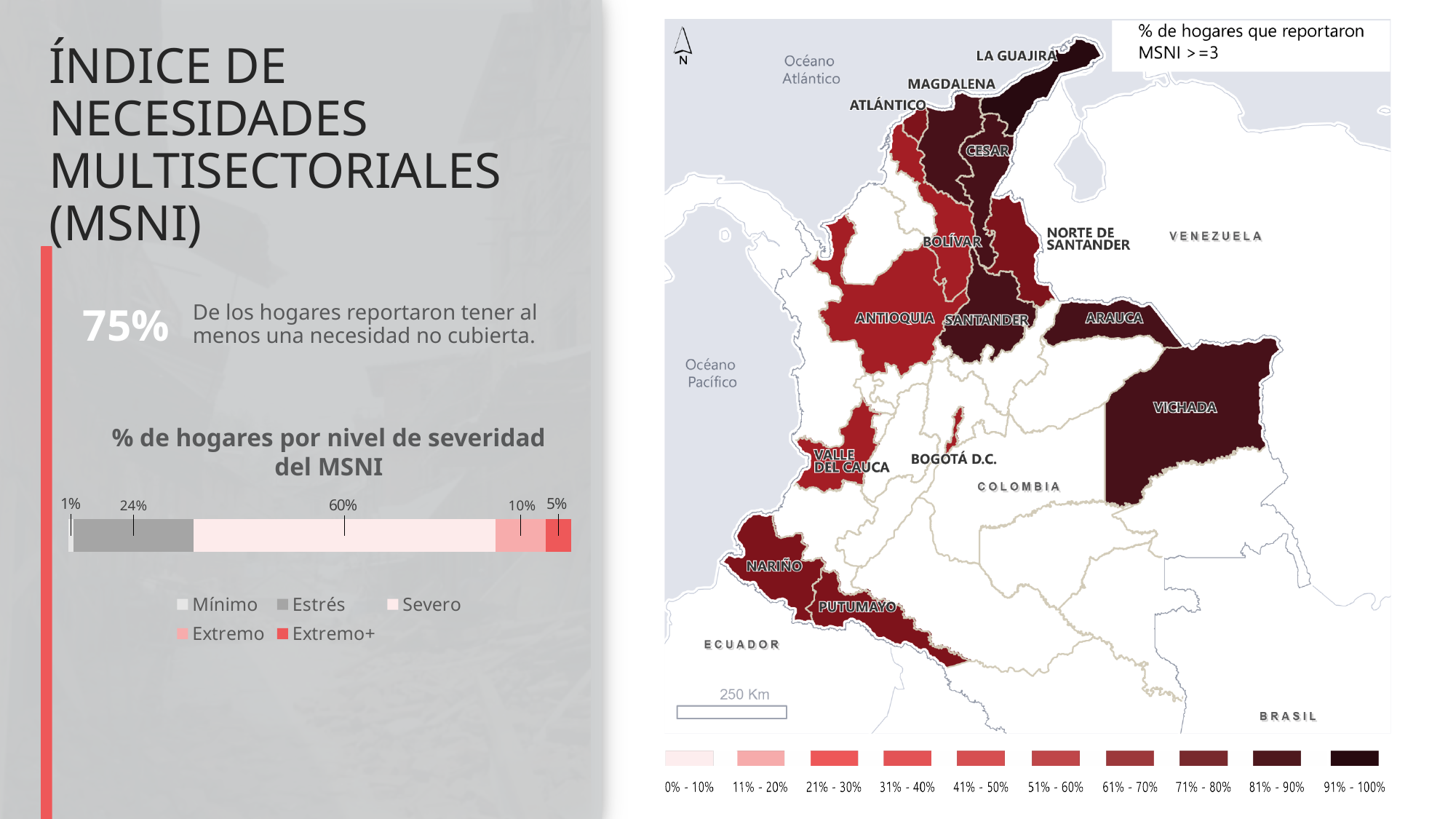
What is the title of the stacked bar chart on the left side of the slide? % de hogares por nivel de severidad del MSNI In the chart '% de hogares por nivel de severidad del MSNI', what percentage of households is in the Mínimo level? 1% How many series does the legend of the chart '% de hogares por nivel de severidad del MSNI' list? 5 In the chart '% de hogares por nivel de severidad del MSNI', what is the total of all the segments in the stacked bar? 100% In the chart '% de hogares por nivel de severidad del MSNI', what percentage of households is in the Severo level? 60% In the chart '% de hogares por nivel de severidad del MSNI', which is larger, Extremo or Extremo+? Extremo In the chart '% de hogares por nivel de severidad del MSNI', which severity level has the largest share of households? Severo What kind of chart is '% de hogares por nivel de severidad del MSNI'? Stacked bar chart In the chart '% de hogares por nivel de severidad del MSNI', what percentage of households is in the Extremo+ level? 5% In the chart '% de hogares por nivel de severidad del MSNI', what is the difference between the Estrés and Extremo percentages? 14% In the chart '% de hogares por nivel de severidad del MSNI', which severity level has the smallest share of households? Mínimo In the chart '% de hogares por nivel de severidad del MSNI', what percentage of households is in the Estrés level? 24%